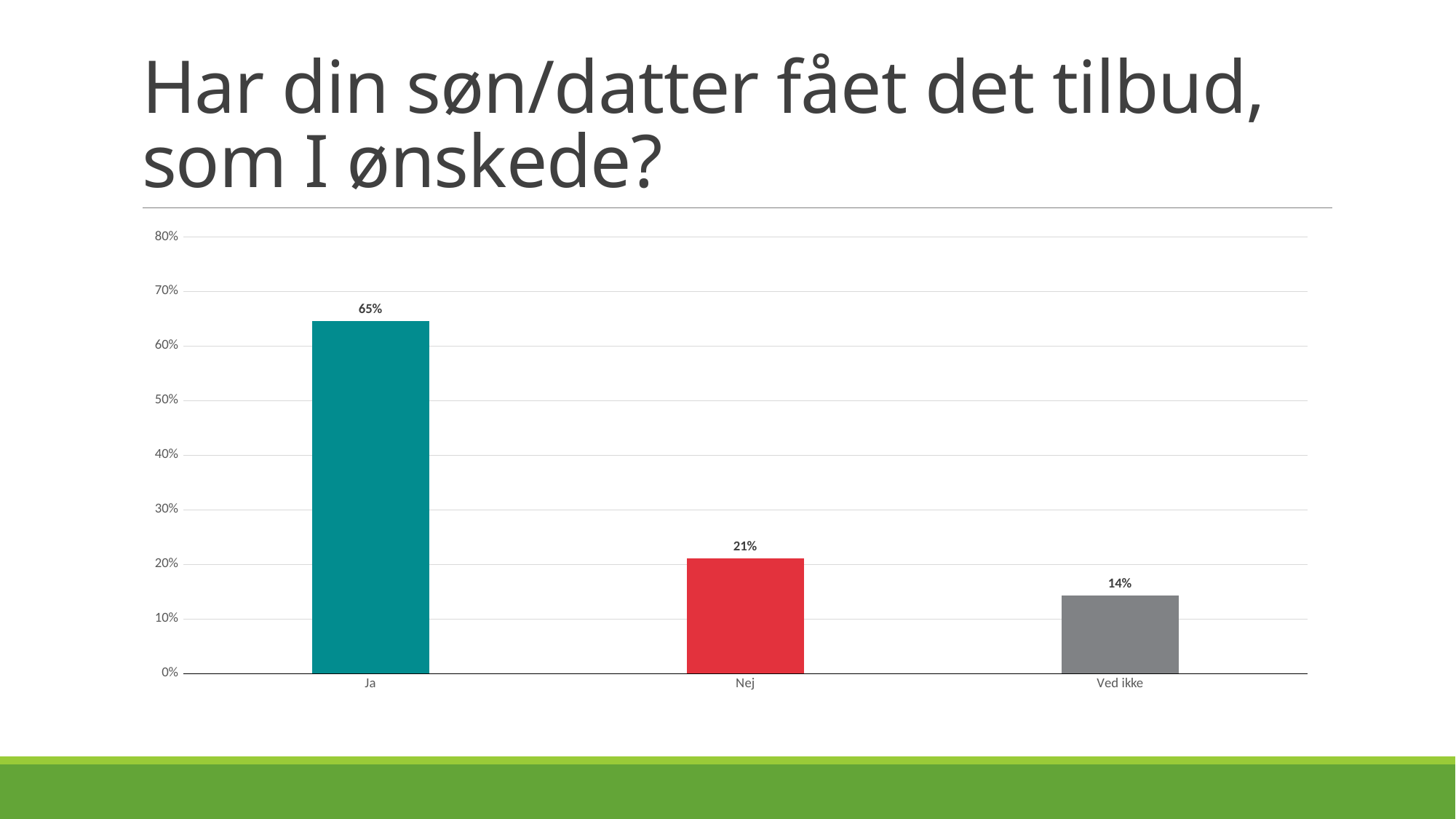
How many categories are shown on the x axis? 3 What colour is the bar for Nej? red What kind of chart is shown on the slide? bar chart Is the value for Ja greater or less than 60%? greater Which category has the highest value? Ja What is the difference between the values for Nej and Ved ikke? 7% What is the difference between the values for Ja and Nej? 44% What is the value for Ved ikke? 14% Which is larger, the value for Nej or the value for Ved ikke? Nej What is the value for Nej? 21% Which category has the lowest value? Ved ikke What is the value for Ja? 65%